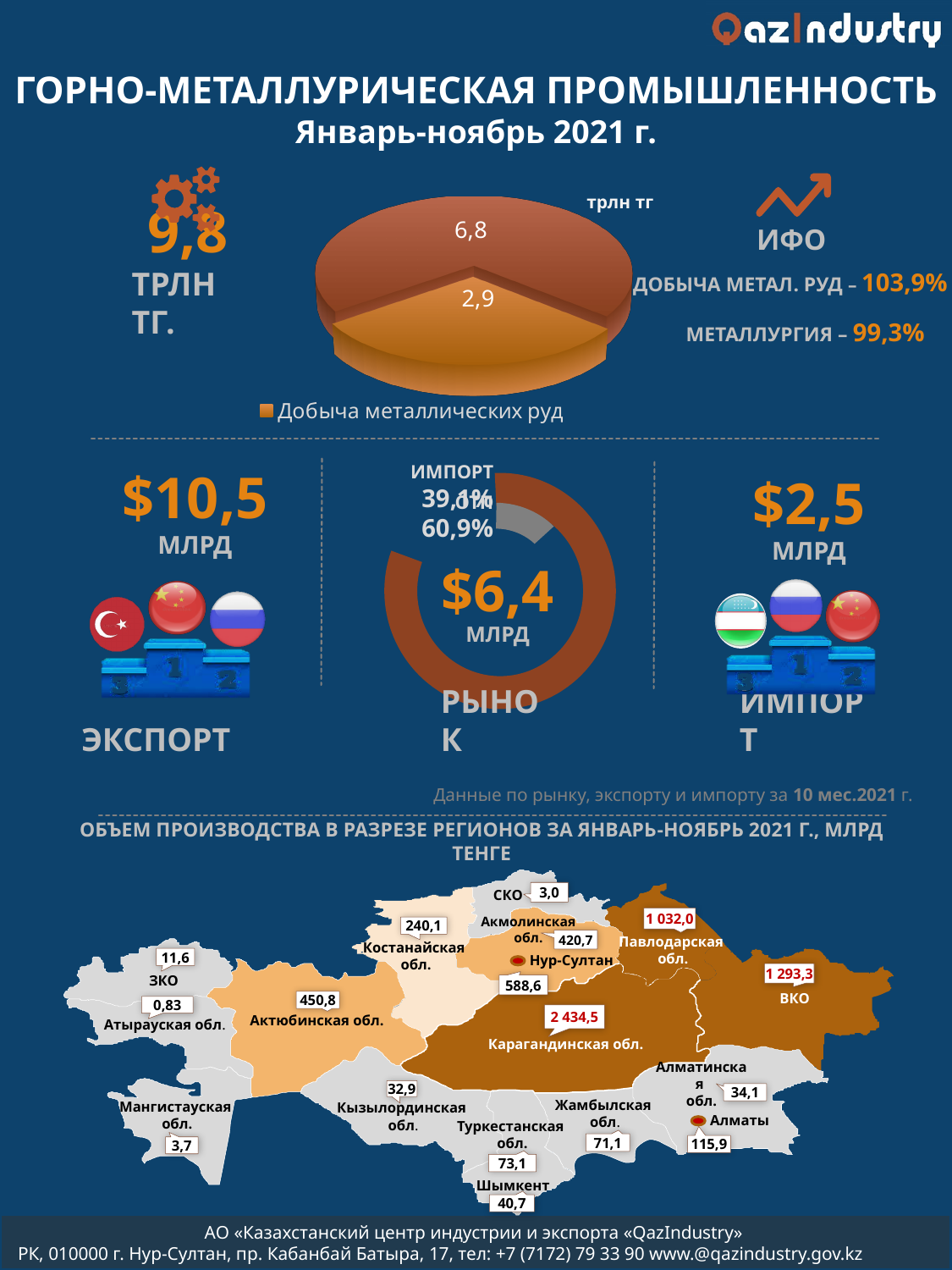
In the pie chart at the top of the slide, what is the difference between the two slice values? 3,9 What legend entry is shown below the pie chart at the top of the slide? Добыча металлических руд In the pie chart at the top of the slide, which slice value is larger, 6,8 or 2,9? 6,8 On the regional map at the bottom of the slide, which region has the highest production volume? Карагандинская обл. What is the value of the smallest slice in the pie chart at the top of the slide? 2,9 How many slices does the pie chart at the top of the slide have? 2 What type of chart is shown at the top of the slide next to the '9,8 ТРЛН ТГ.' figure? Pie chart On the regional map at the bottom of the slide, what is the production volume for Карагандинская обл.? 2 434,5 On the regional map at the bottom of the slide, what is the production volume for ВКО? 1 293,3 What unit label is printed next to the pie chart at the top of the slide? трлн тг What is the value of the largest slice in the pie chart at the top of the slide? 6,8 What value is printed in the centre of the ring (donut) chart in the middle of the slide? $6,4 млрд